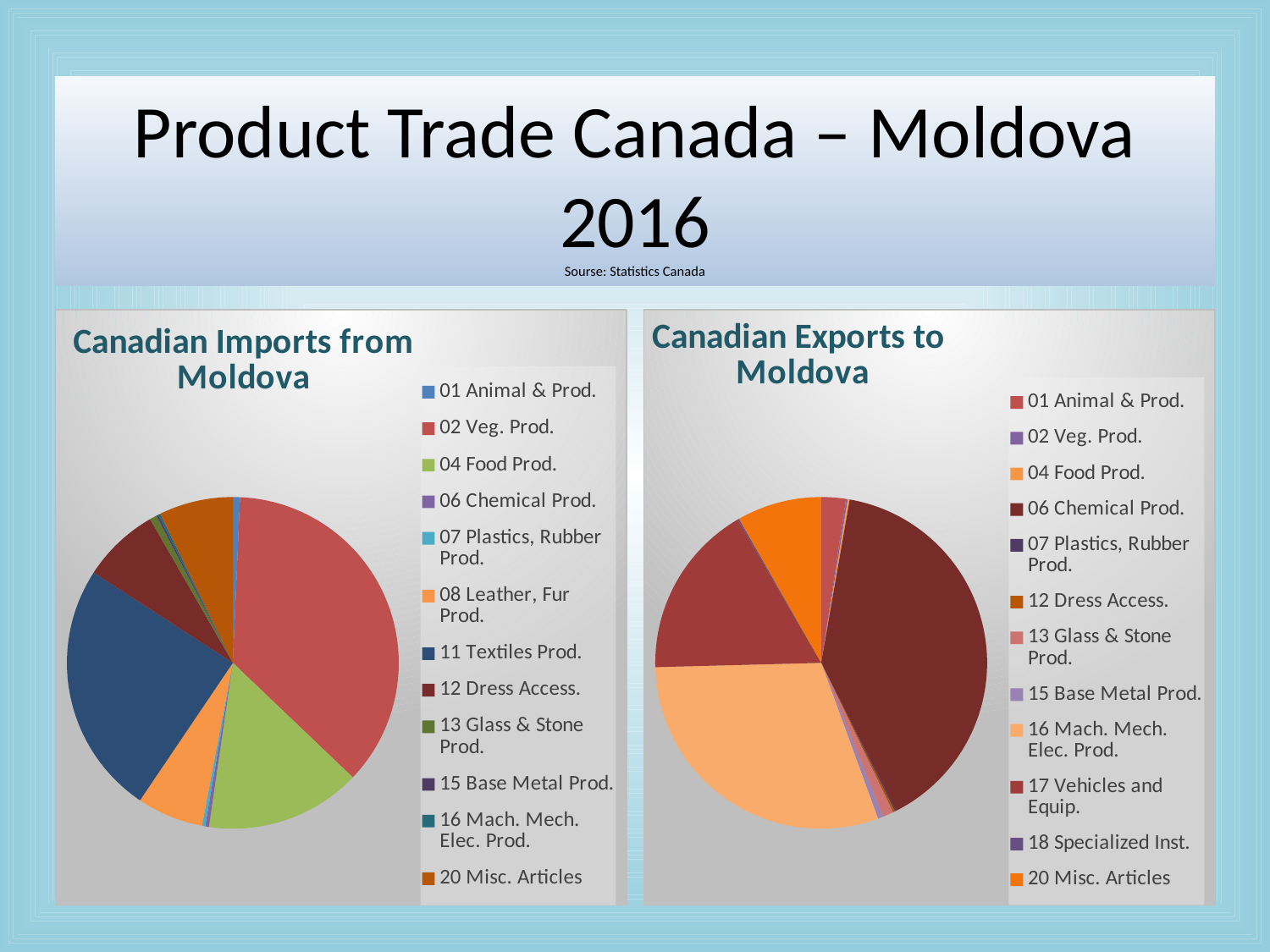
In the "Canadian Exports to Moldova" chart, which slice is larger: 17 Vehicles and Equip. or 20 Misc. Articles? 17 Vehicles and Equip. In the "Canadian Imports from Moldova" chart, which slice is larger: 02 Veg. Prod. or 11 Textiles Prod.? 02 Veg. Prod. In the "Canadian Imports from Moldova" chart, which slice is larger: 04 Food Prod. or 08 Leather, Fur Prod.? 04 Food Prod. What kind of chart is the "Canadian Imports from Moldova" chart? Pie chart How many categories does the legend of the "Canadian Imports from Moldova" chart list? 12 In the "Canadian Exports to Moldova" chart, which category has the largest slice? 06 Chemical Prod. What is the title of the pie chart on the right side of the slide? Canadian Exports to Moldova What kind of chart is the "Canadian Exports to Moldova" chart? Pie chart According to the slide, what is the source of the data shown in the charts? Statistics Canada How many categories does the legend of the "Canadian Exports to Moldova" chart list? 12 In the "Canadian Imports from Moldova" chart, which category has the largest slice? 02 Veg. Prod.